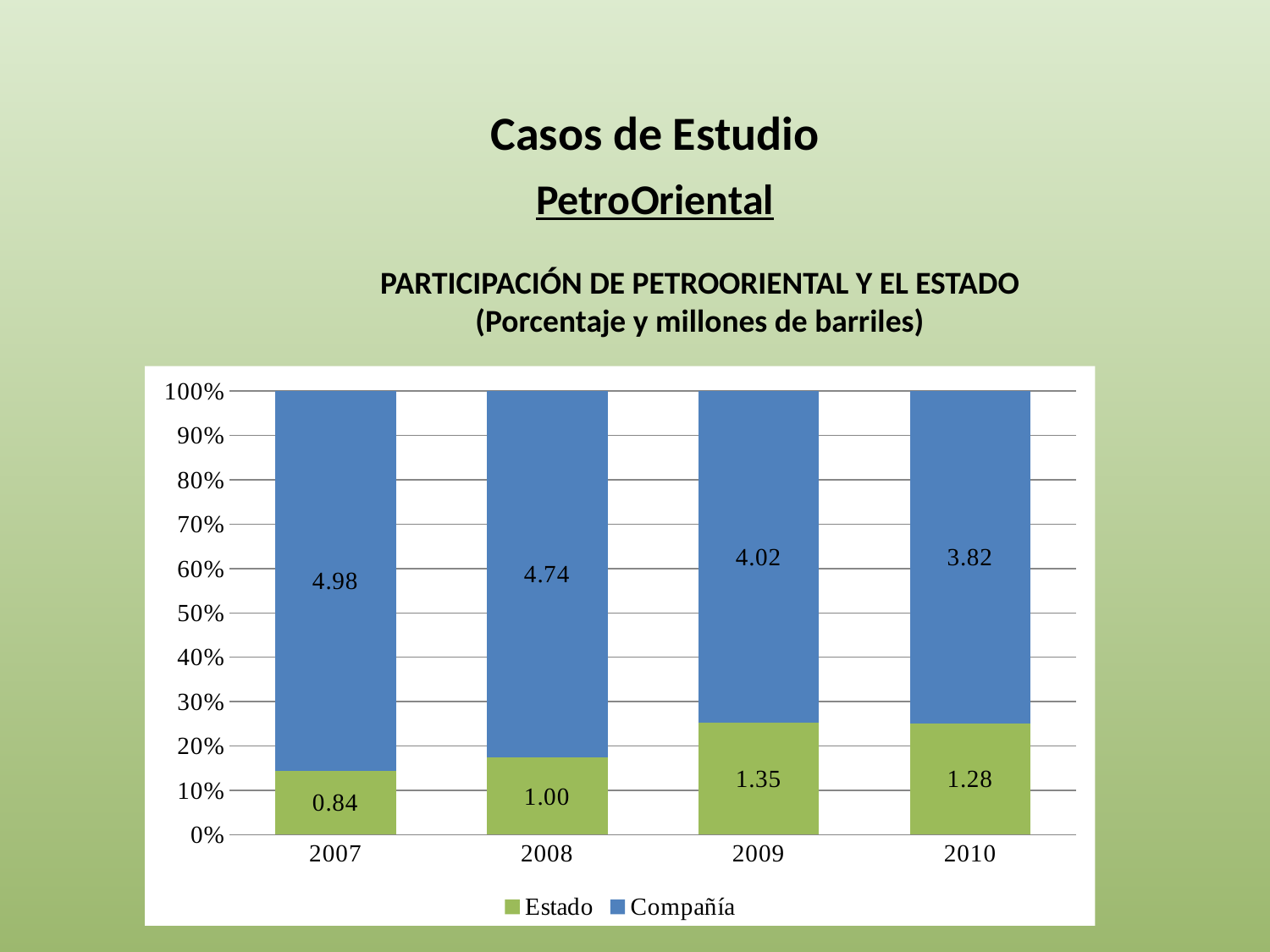
How many series does the legend list? 2 What value is shown for Estado in 2007? 0.84 How many years are shown on the x axis? 4 Is the Estado share of the 2007 bar greater or less than 20%? less In which year is the Compañía value lowest? 2010 Which is larger, the Estado value in 2008 or in 2010? 2010 What is the difference between the Compañía values for 2007 and 2008? 0.24 What value is shown for Compañía in 2009? 4.02 What value is shown for Compañía in 2010? 3.82 In which year is the Estado value highest? 2009 Is the Compañía share of the 2010 bar greater or less than 70%? greater What is the sum of the Estado and Compañía values for 2009? 5.37